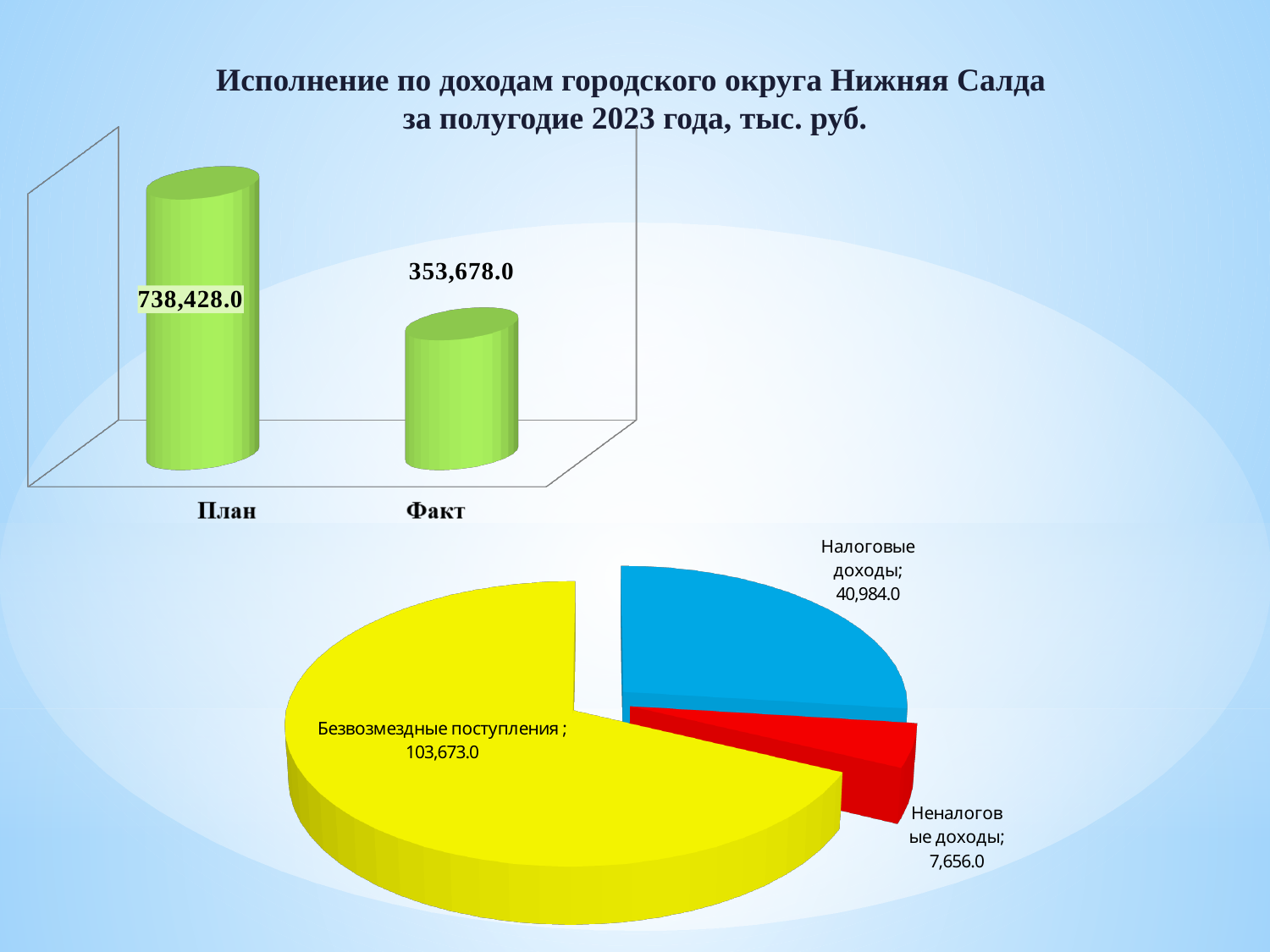
In the pie chart at the bottom of the slide, what is the value for Неналоговые доходы? 7,656.0 In the pie chart at the bottom of the slide, what colour is the Неналоговые доходы slice? Red In the bar chart at the top of the slide, which category has the higher value, План or Факт? План In the bar chart at the top of the slide, what is the value for План? 738,428.0 In the pie chart at the bottom of the slide, what is the value for Налоговые доходы? 40,984.0 In the pie chart at the bottom of the slide, which slice is the smallest? Неналоговые доходы What kind of chart is shown at the top of the slide? Bar chart In the pie chart at the bottom of the slide, what is the difference between Безвозмездные поступления and Налоговые доходы? 62,689.0 In the pie chart at the bottom of the slide, which slice is the largest? Безвозмездные поступления In the bar chart at the top of the slide, what is the difference between the План and Факт values? 384,750.0 In the bar chart at the top of the slide, how many categories are shown? 2 In the bar chart at the top of the slide, what is the value for Факт? 353,678.0